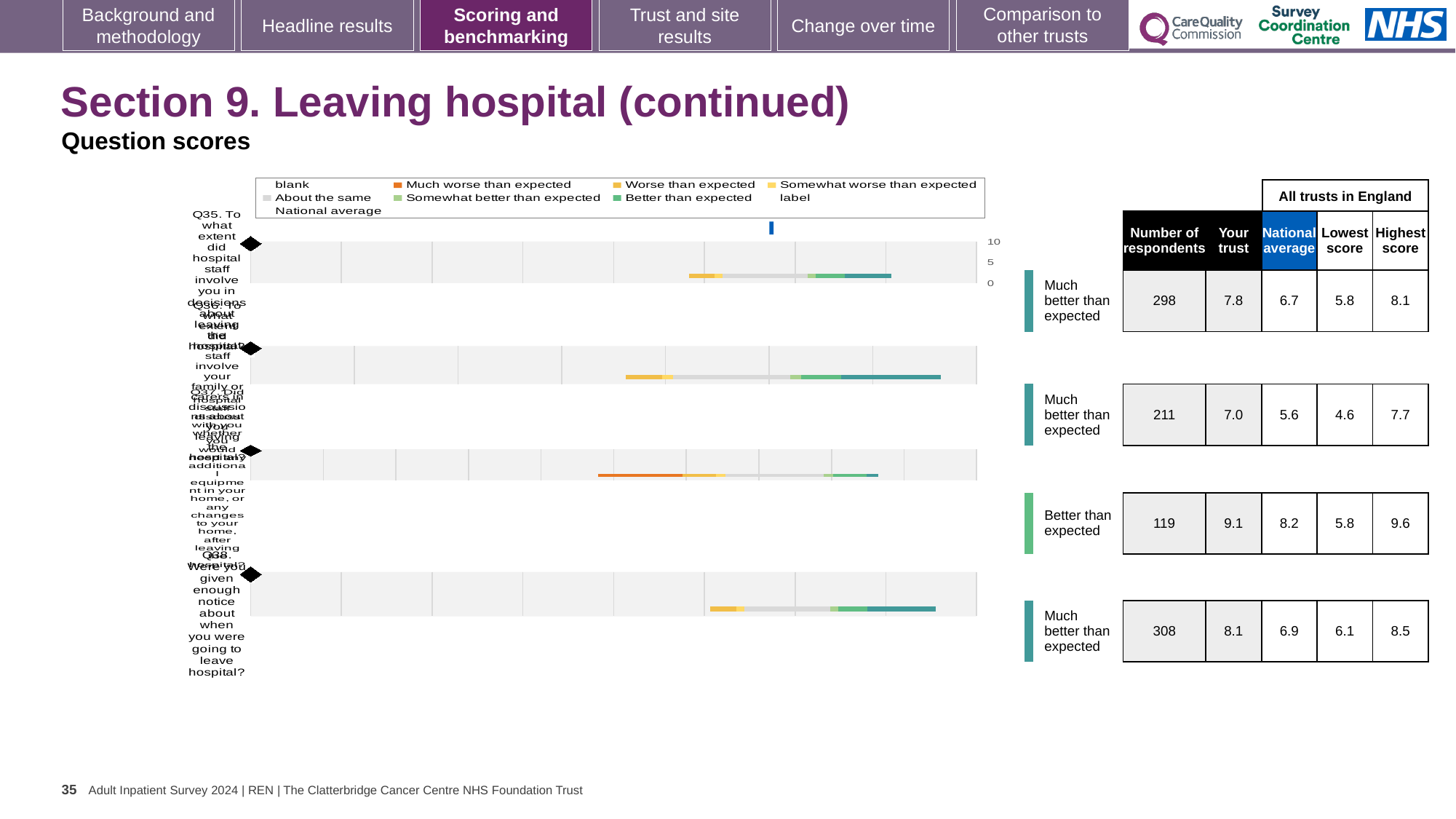
What is the difference between the highest score and the lowest score for the third row (119 respondents)? 3.8 What is the national average for Q35 (the first row of the chart)? 6.7 What is the lowest score among all trusts in England for Q38 (the last row of the chart)? 6.1 What is the smallest number of respondents shown for any row on the slide? 119 What kind of chart is shown on the slide? Bar chart What is the 'Your trust' score for Q35 (the first row of the chart)? 7.8 By how much does the 'Your trust' score for Q35 (first row) exceed the national average? 1.1 How many question rows are plotted in the chart? 4 For Q38 (the last row), which is larger: the 'Your trust' score or the national average? Your trust How many respondents are shown for Q38 (the last row of the chart)? 308 What is the highest 'Your trust' score shown on the slide? 9.1 What benchmark category is shown next to Q38 (the last row of the chart)? Much better than expected